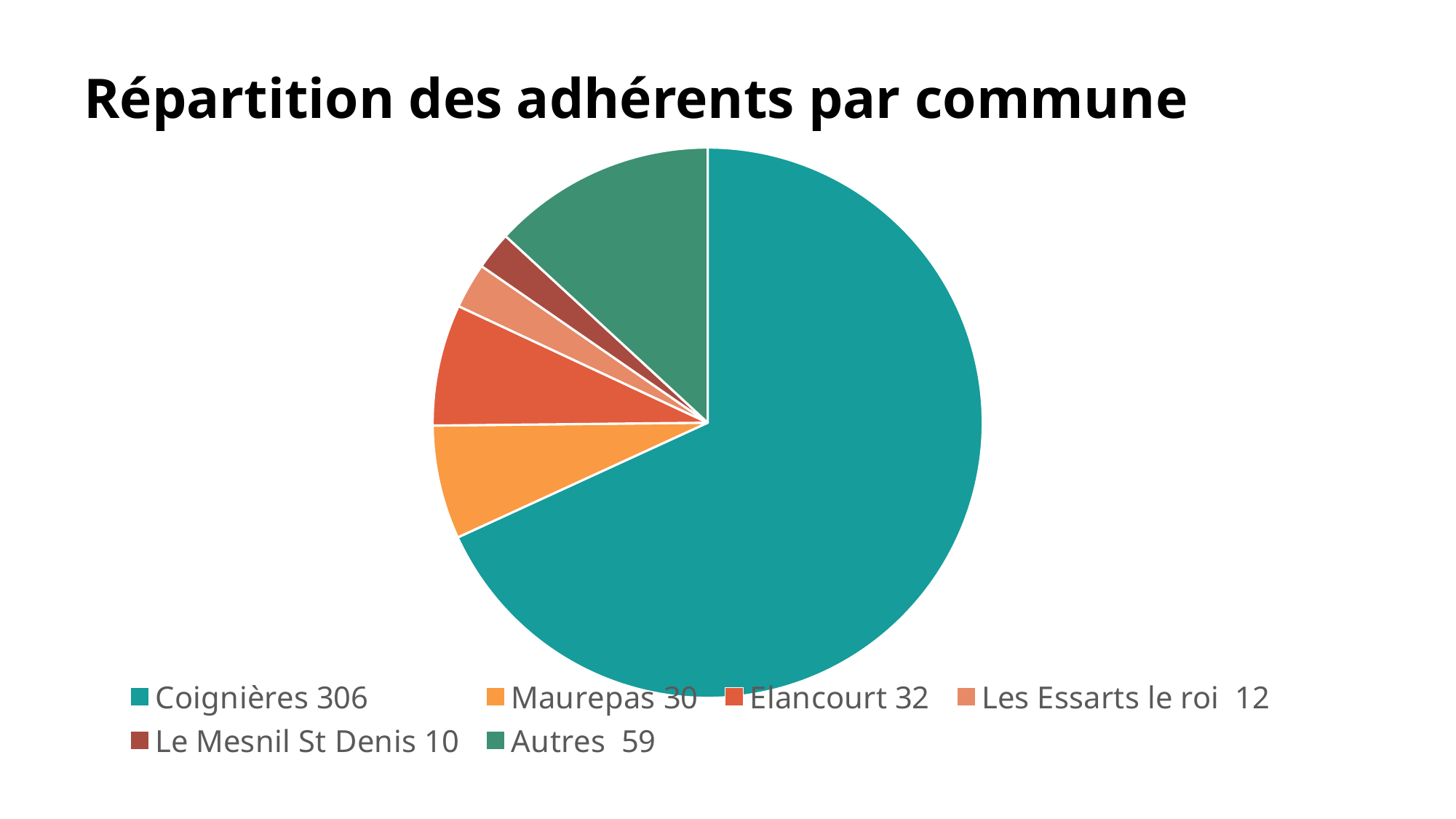
Which category has the smallest number of adherents? Le Mesnil St Denis How many slices does the pie chart have? 6 How many adherents are from Les Essarts le roi? 12 Which has more adherents, Elancourt or Maurepas? Elancourt How many adherents are from Maurepas? 30 How many adherents are from Elancourt? 32 How many adherents are in the Autres category? 59 Which commune has the largest number of adherents? Coignières What type of chart is shown on the slide? pie chart How many adherents are from Coignières? 306 What is the title of the chart? Répartition des adhérents par commune What is the difference between the number of adherents from Coignières and from Autres? 247